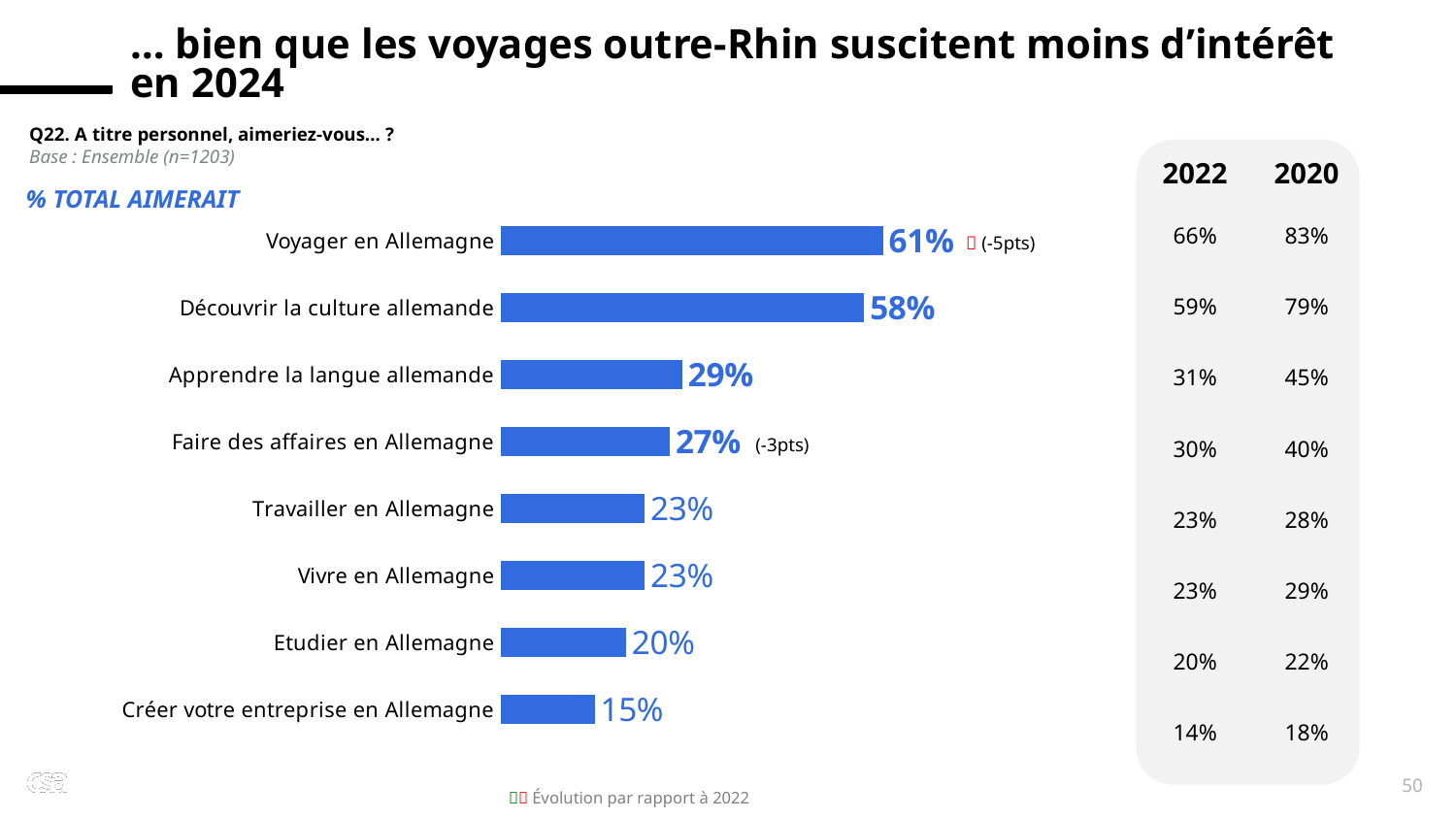
What is the difference between "Voyager en Allemagne" and "Découvrir la culture allemande"? 3 points What is the value for "Vivre en Allemagne"? 23% What is the value for "Voyager en Allemagne"? 61% What is the value for "Créer votre entreprise en Allemagne"? 15% Which category has the highest value? Voyager en Allemagne Which category has the lowest value? Créer votre entreprise en Allemagne What is the value for "Apprendre la langue allemande"? 29% Which is larger: "Faire des affaires en Allemagne" or "Travailler en Allemagne"? Faire des affaires en Allemagne What kind of chart is shown on the slide? Bar chart What is the difference between "Apprendre la langue allemande" and "Etudier en Allemagne"? 9 points What change versus 2022 is indicated next to "Voyager en Allemagne"? -5pts How many categories are shown in the bar chart? 8